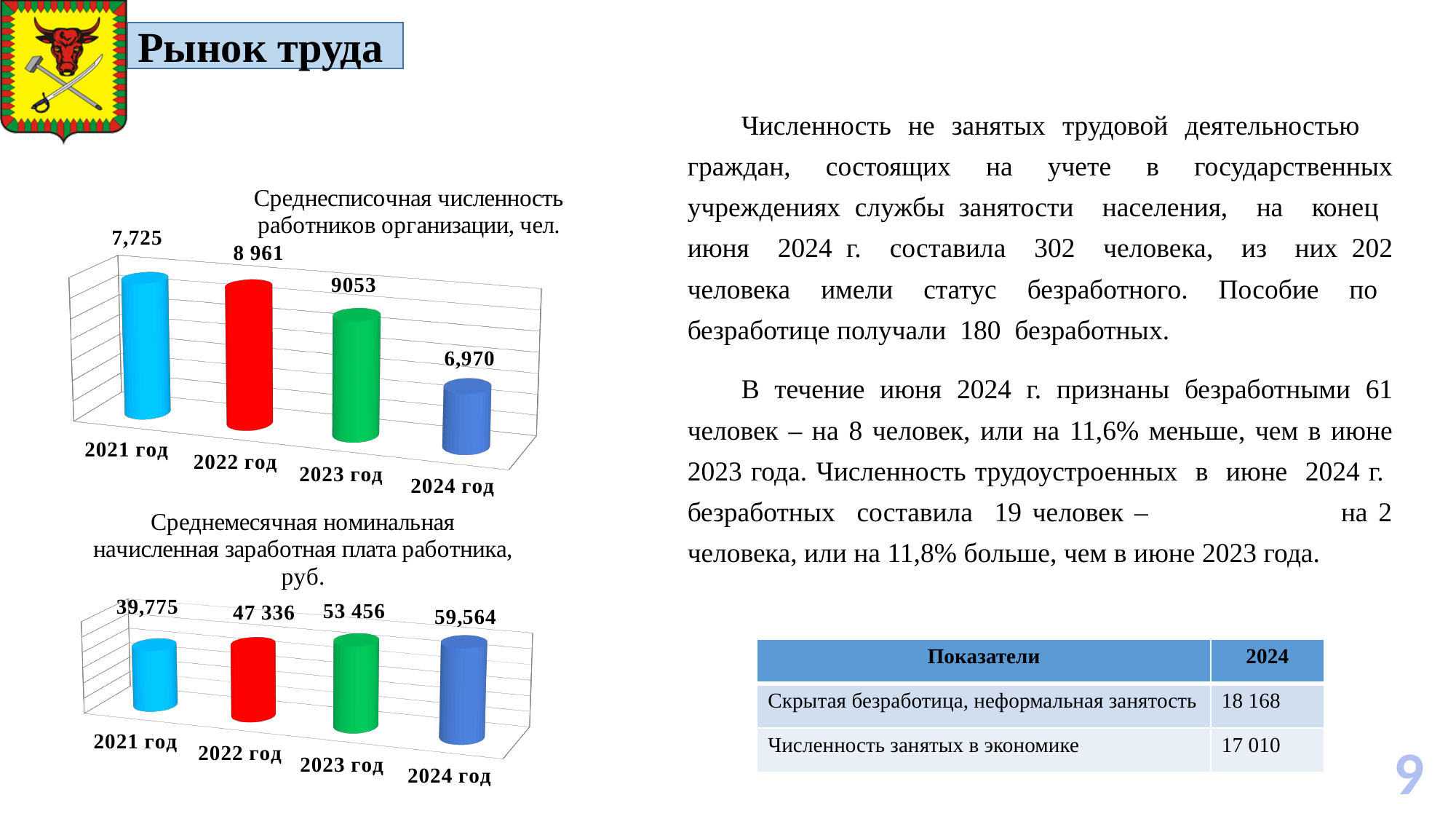
In the bottom chart (Среднемесячная номинальная начисленная заработная плата работника, руб.), which is larger, the value for 2021 год or 2023 год? 2023 год What kind of chart is the bottom chart (Среднемесячная номинальная начисленная заработная плата работника, руб.)? bar chart In the top chart (Среднесписочная численность работников организации, чел.), what is the value for 2024 год? 6,970 In the top chart (Среднесписочная численность работников организации, чел.), how many years are shown? 4 In the bottom chart (Среднемесячная номинальная начисленная заработная плата работника, руб.), what is the value for 2022 год? 47 336 In the top chart (Среднесписочная численность работников организации, чел.), what is the difference between the values for 2023 год and 2024 год? 2083 In the bottom chart (Среднемесячная номинальная начисленная заработная плата работника, руб.), what is the value for 2024 год? 59,564 In the bottom chart (Среднемесячная номинальная начисленная заработная плата работника, руб.), what is the difference between the values for 2023 год and 2022 год? 6120 In the top chart (Среднесписочная численность работников организации, чел.), what is the value for 2021 год? 7,725 In the bottom chart (Среднемесячная номинальная начисленная заработная плата работника, руб.), do the values rise or fall from 2021 год to 2024 год? rise In the top chart (Среднесписочная численность работников организации, чел.), which year has the lowest value? 2024 год